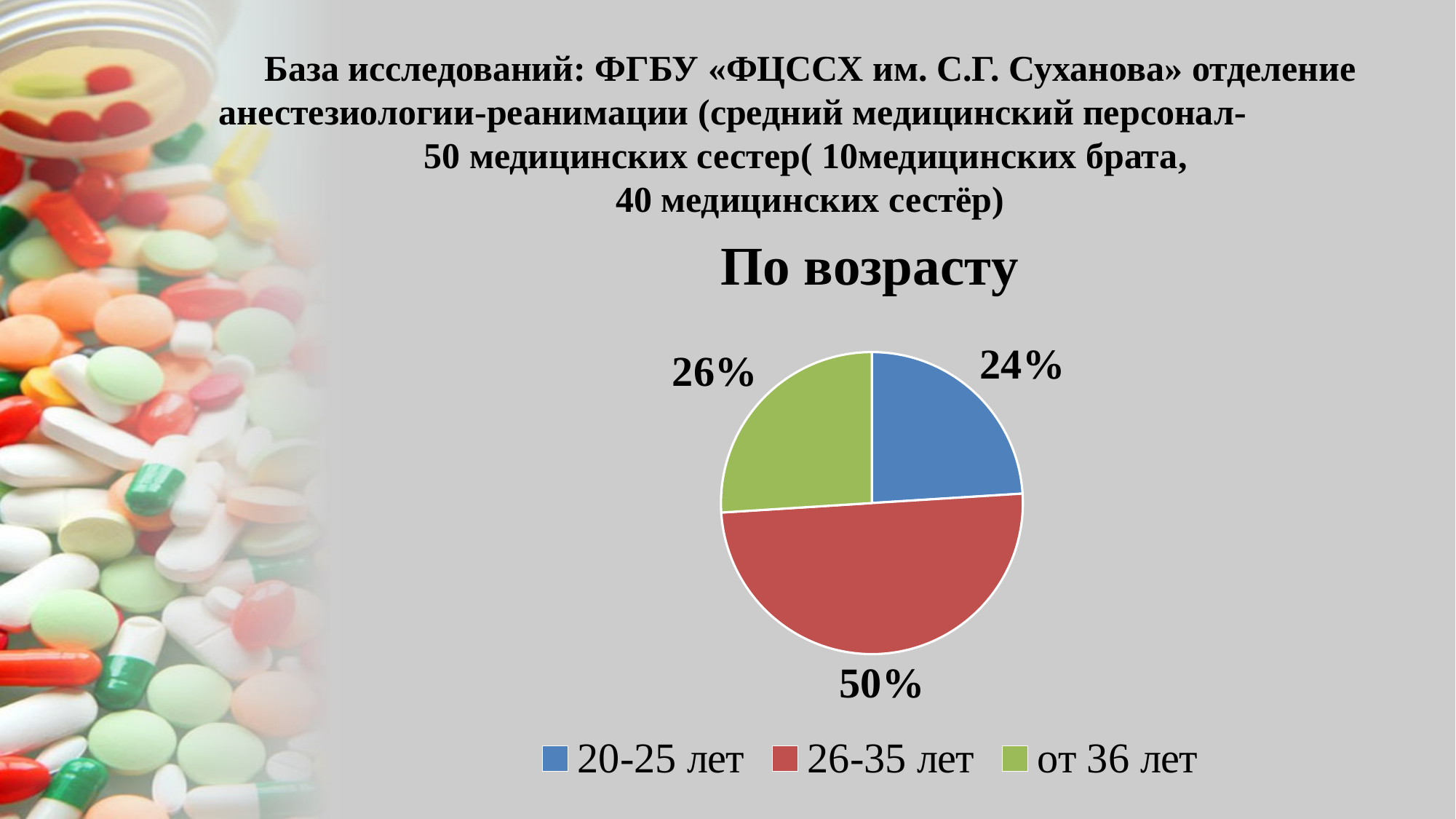
What share of the pie does the 20-25 лет slice have? 24% What is the difference between the shares of от 36 лет and 20-25 лет? 2% What is the difference between the shares of 26-35 лет and от 36 лет? 24% Which age group has the smallest share of the pie? 20-25 лет What share of the pie does the 26-35 лет slice have? 50% How many slices does the pie chart have? 3 What share of the pie does the от 36 лет slice have? 26% How many entries does the legend list? 3 What is the title of the chart? По возрасту Which is larger, the share for 20-25 лет or the share for 26-35 лет? 26-35 лет Which age group has the largest share of the pie? 26-35 лет What kind of chart is shown on the slide? pie chart